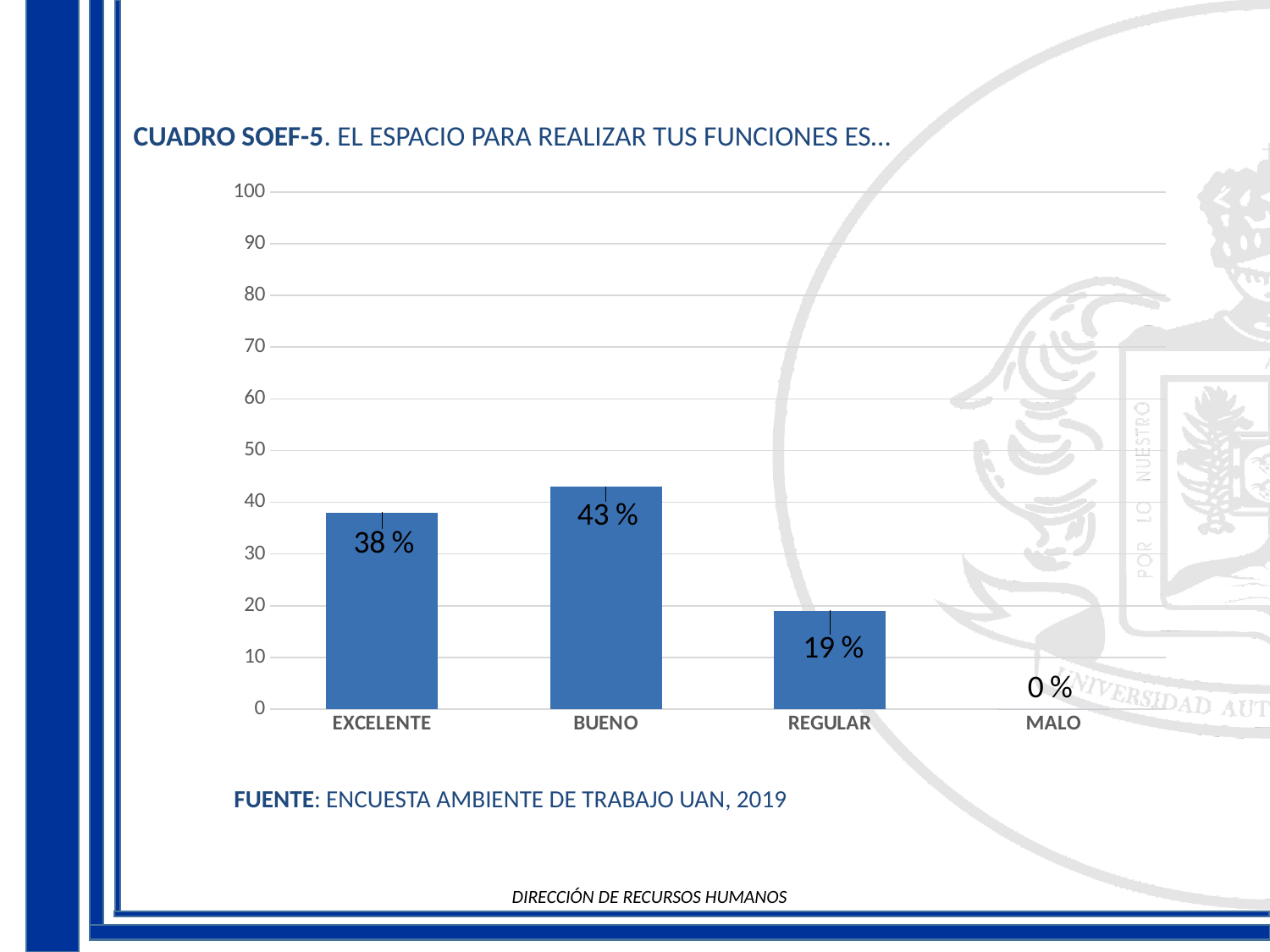
Which category has the highest value? BUENO What kind of chart is shown on the slide? bar chart What is the value for MALO? 0 % What is the value for REGULAR? 19 % What is the value for BUENO? 43 % Which category has the lowest value? MALO Which is larger, the value for EXCELENTE or the value for REGULAR? EXCELENTE How many categories are shown on the x axis? 4 What is the difference between the values for BUENO and EXCELENTE? 5 % What is the value for EXCELENTE? 38 % What is the difference between the values for EXCELENTE and REGULAR? 19 % Is the value for BUENO greater or less than 40? greater